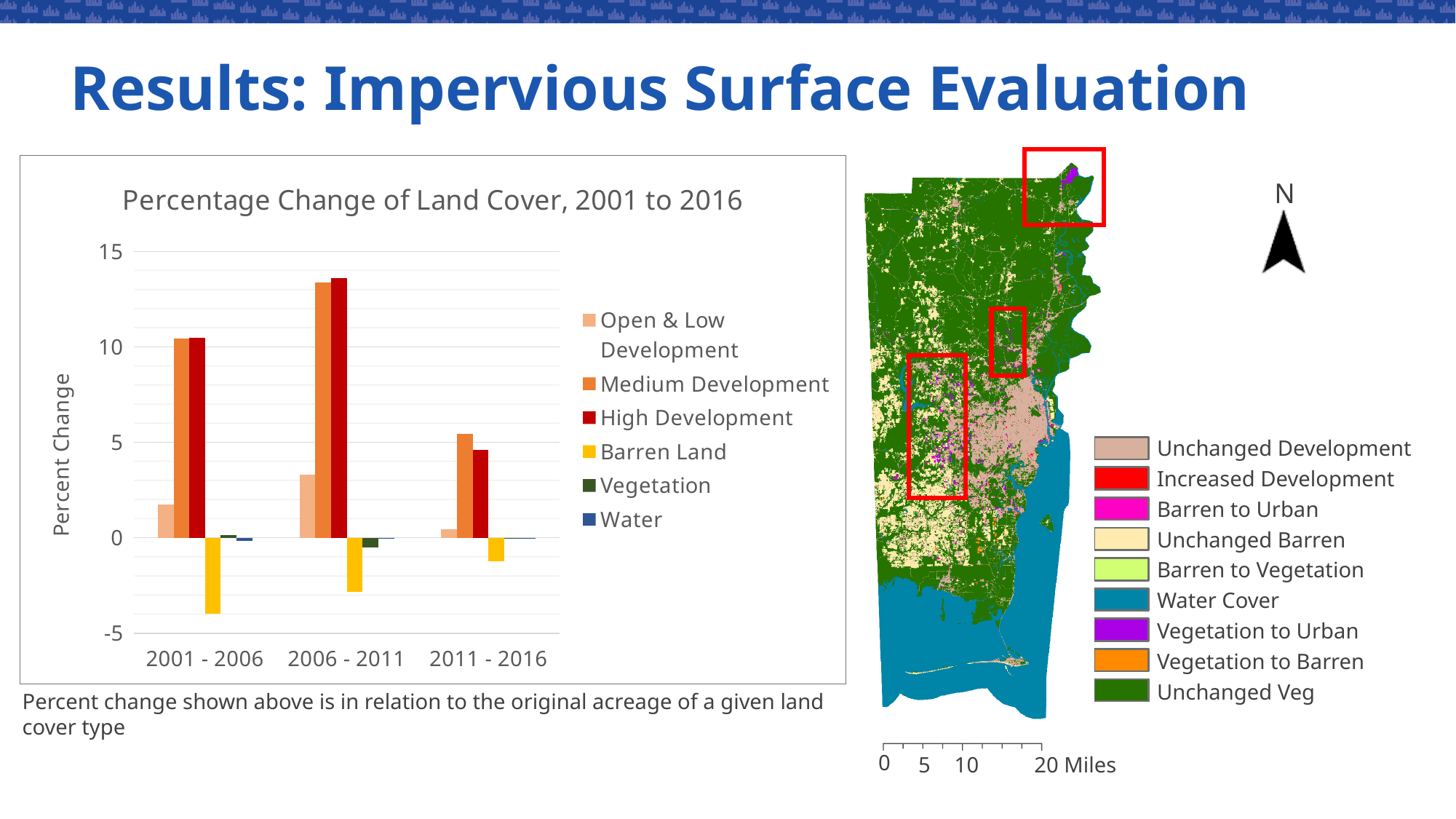
How many time periods are shown on the x axis of the bar chart? 3 Is the value for Open & Low Development in 2006 - 2011 greater or less than 5? less Is the value for Medium Development in 2006 - 2011 greater or less than 10? greater How many series does the legend of the bar chart list? 6 In 2011 - 2016, which is larger: Medium Development or High Development? Medium Development In which period is the Medium Development bar highest? 2006 - 2011 What kind of chart is shown on the left of the slide? bar chart Is the value for Barren Land in 2001 - 2006 greater or less than 0? less What is the title of the chart on the left of the slide? Percentage Change of Land Cover, 2001 to 2016 What is the label of the vertical axis of the bar chart? Percent Change In which period is the Barren Land bar lowest (most negative)? 2001 - 2006 Does the Barren Land value rise or fall across the three periods from 2001 - 2006 to 2011 - 2016? rise